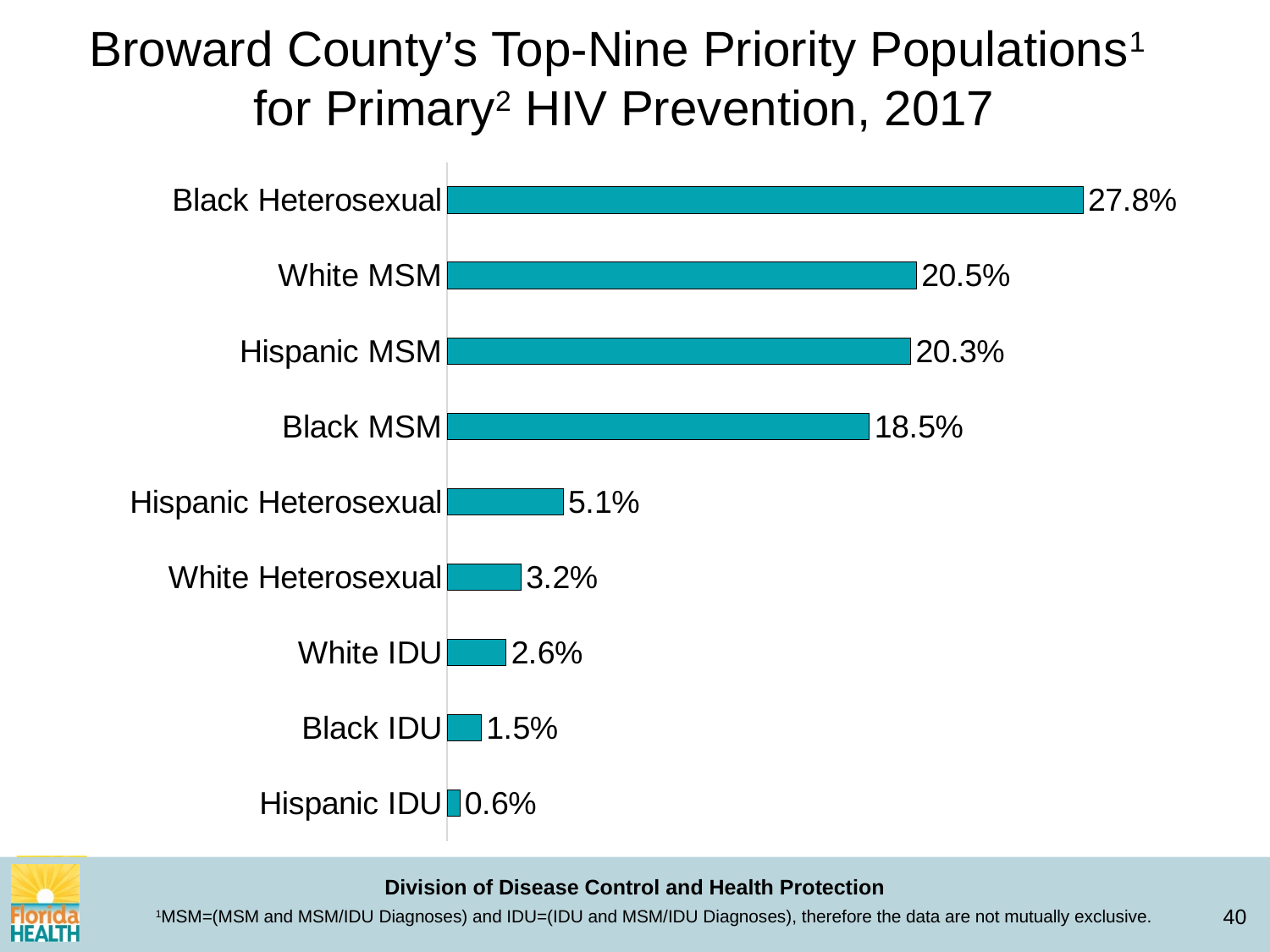
What kind of chart is shown on the slide? Bar chart What is the difference between the values for Hispanic Heterosexual and White Heterosexual? 1.9% Which population has the lowest value? Hispanic IDU What is the value for Black Heterosexual? 27.8% What colour are the bars in the chart? Teal What is the value for White IDU? 2.6% What is the difference between the values for Black Heterosexual and Black MSM? 9.3% What is the value for Hispanic MSM? 20.3% Which is larger, the value for Black IDU or the value for White IDU? White IDU Which population has the highest value? Black Heterosexual Which is larger, the value for Black MSM or the value for Hispanic Heterosexual? Black MSM How many populations are shown in the chart? 9